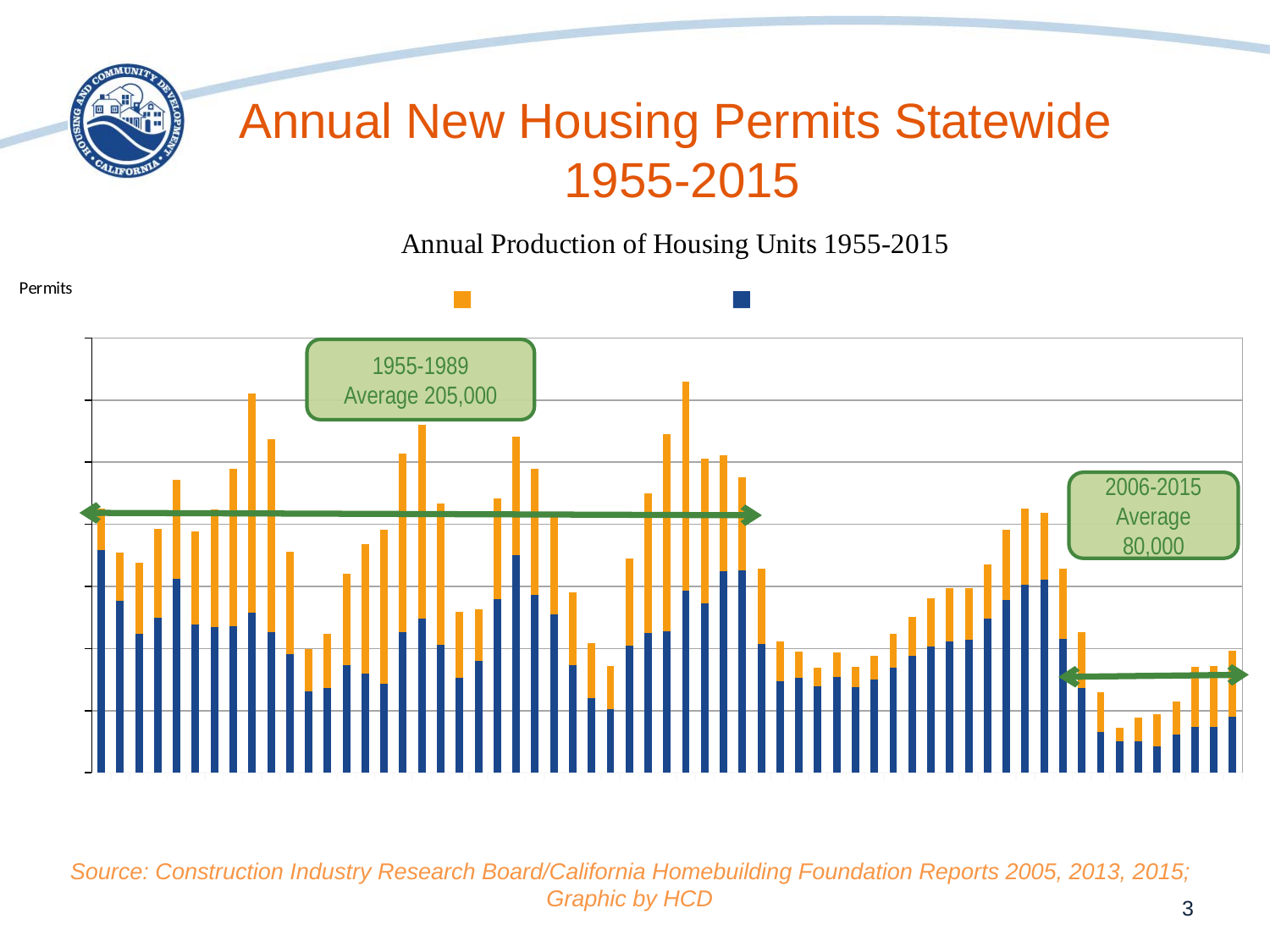
What average annual value does the chart annotation give for 1955-1989? 205,000 Which colour represents the series stacked on top of the bars? Orange What is the difference between the annotated averages for 1955-1989 and 2006-2015? 125,000 What kind of chart is shown on the slide? Stacked bar chart How many years does the chart cover, according to its title? 61 What label is shown on the vertical axis of the chart? Permits How many series does the chart's legend show? 2 What average annual value does the chart annotation give for 2006-2015? 80,000 What is the title of the chart? Annual Production of Housing Units 1955-2015 Which period has the higher annotated average, 1955-1989 or 2006-2015? 1955-1989